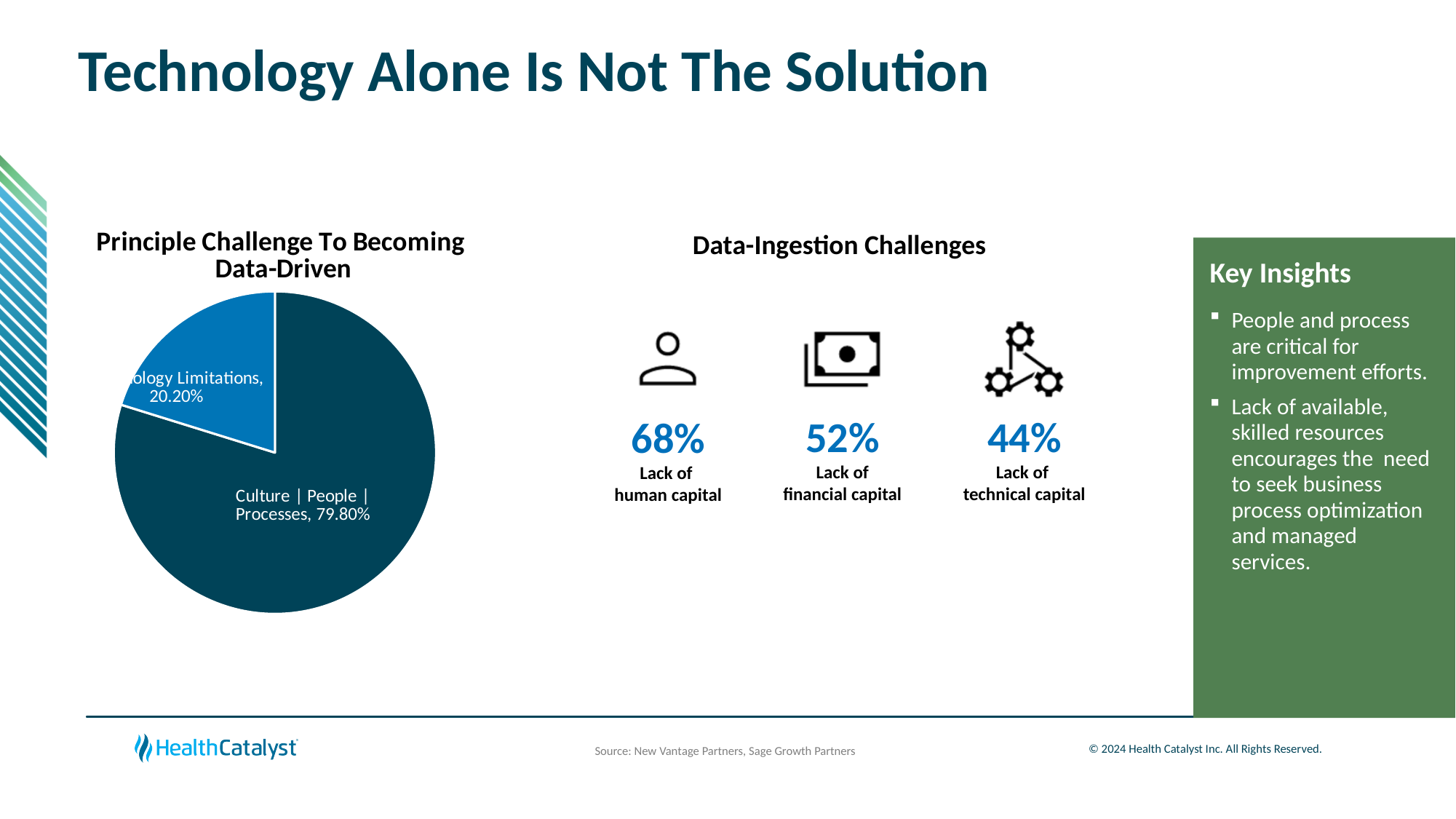
In the 'Principle Challenge To Becoming Data-Driven' pie chart, is the Culture | People | Processes slice larger or smaller than the other slice? Larger In the 'Principle Challenge To Becoming Data-Driven' pie chart, what percentage is shown for Culture | People | Processes? 79.80% What is the title of the pie chart on the left of the slide? Principle Challenge To Becoming Data-Driven In the 'Principle Challenge To Becoming Data-Driven' pie chart, what colour is the Culture | People | Processes slice? Dark blue In the 'Principle Challenge To Becoming Data-Driven' pie chart, is the value for Culture | People | Processes greater or less than 50%? greater How many slices does the 'Principle Challenge To Becoming Data-Driven' pie chart have? 2 In the 'Principle Challenge To Becoming Data-Driven' pie chart, what is the difference in percentage points between the Culture | People | Processes slice and the smaller slice? 59.60 In the 'Principle Challenge To Becoming Data-Driven' pie chart, what percentage is shown for the smaller, light-blue slice? 20.20% What type of chart is 'Principle Challenge To Becoming Data-Driven'? Pie chart In the 'Principle Challenge To Becoming Data-Driven' pie chart, which slice is the largest? Culture | People | Processes